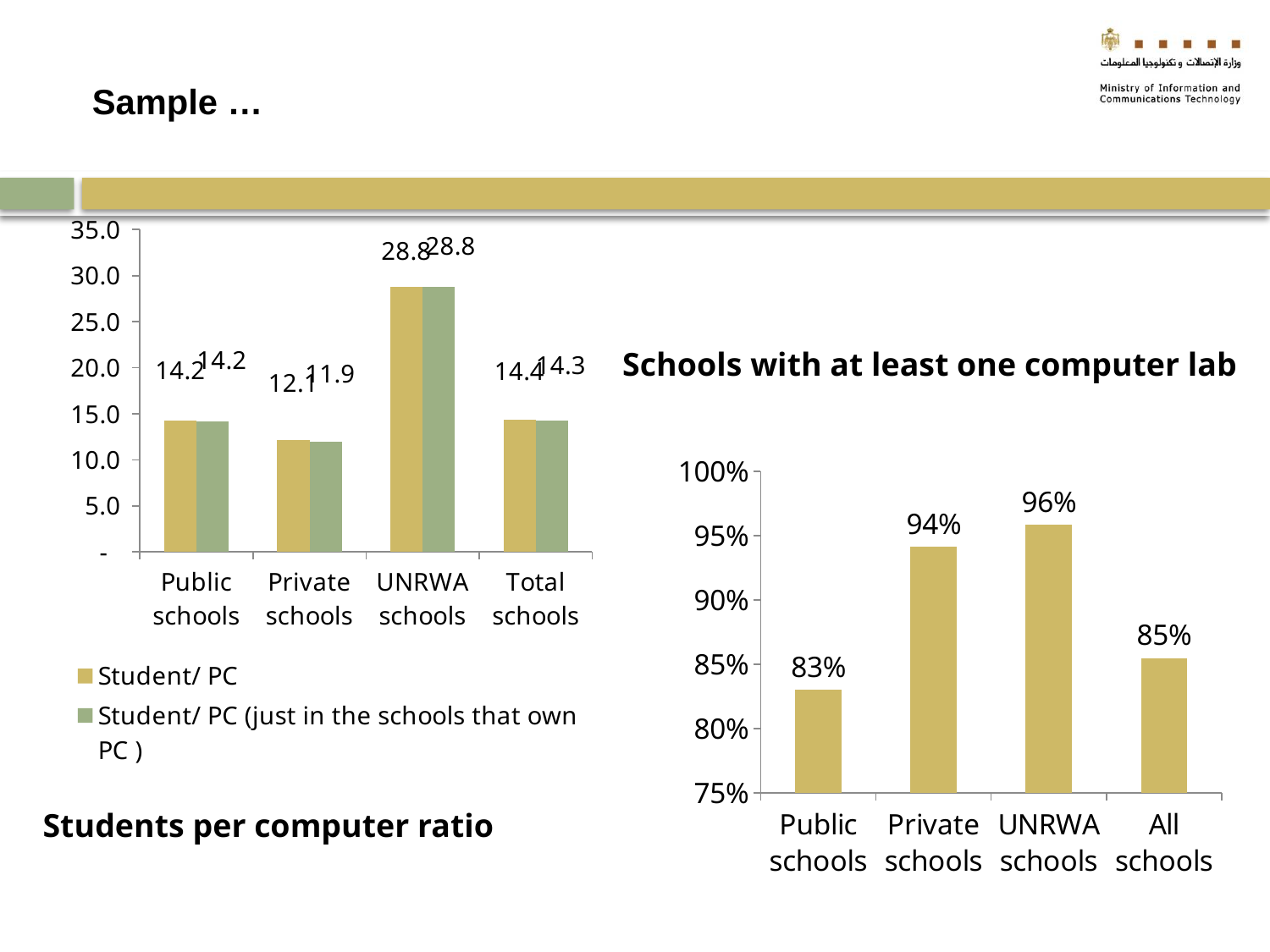
What kind of chart is the 'Students per computer ratio' chart? Bar chart In the 'Schools with at least one computer lab' chart, what is the difference between UNRWA schools and Public schools? 13% In the 'Students per computer ratio' chart, which category has the highest Student/ PC value? UNRWA schools In the 'Schools with at least one computer lab' chart, which category has the lowest value? Public schools In the 'Students per computer ratio' chart, what is the 'Student/ PC (just in the schools that own PC )' value for Private schools? 11.9 In the 'Schools with at least one computer lab' chart, what is the value for Private schools? 94% In the 'Students per computer ratio' chart, is the Student/ PC value for Private schools greater or less than the value for Total schools? less In the 'Students per computer ratio' chart, what is the Student/ PC value for UNRWA schools? 28.8 In the 'Schools with at least one computer lab' chart, what is the value for All schools? 85% In the 'Schools with at least one computer lab' chart, how many categories are shown on the x axis? 4 In the 'Students per computer ratio' chart, how many series does the legend list? 2 In the 'Schools with at least one computer lab' chart, which category has the highest value? UNRWA schools